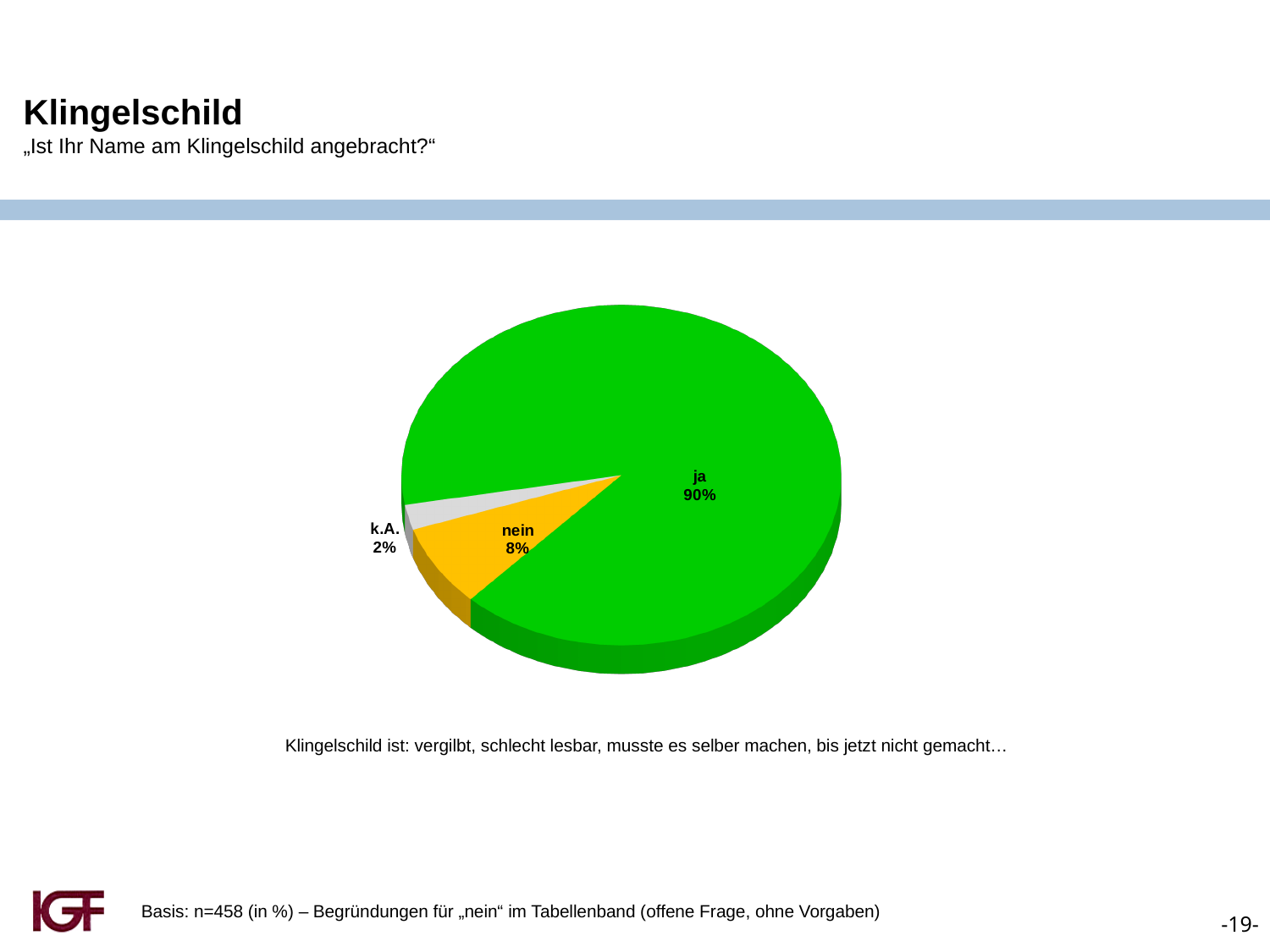
What percentage of respondents answered "ja"? 90% What is the sample size (n) stated at the bottom of the slide? n=458 What percentage of respondents answered "nein"? 8% What is the difference in percentage points between "ja" and "nein"? 82 Which slice of the pie is the largest? ja What type of chart is shown on the slide? pie chart Which is larger, the share for "nein" or the share for "k.A."? nein What is the difference in percentage points between "nein" and "k.A."? 6 What percentage is shown for "k.A."? 2% What colour is the "ja" slice of the pie? green How many slices does the pie chart have? 3 Which slice of the pie is the smallest? k.A.